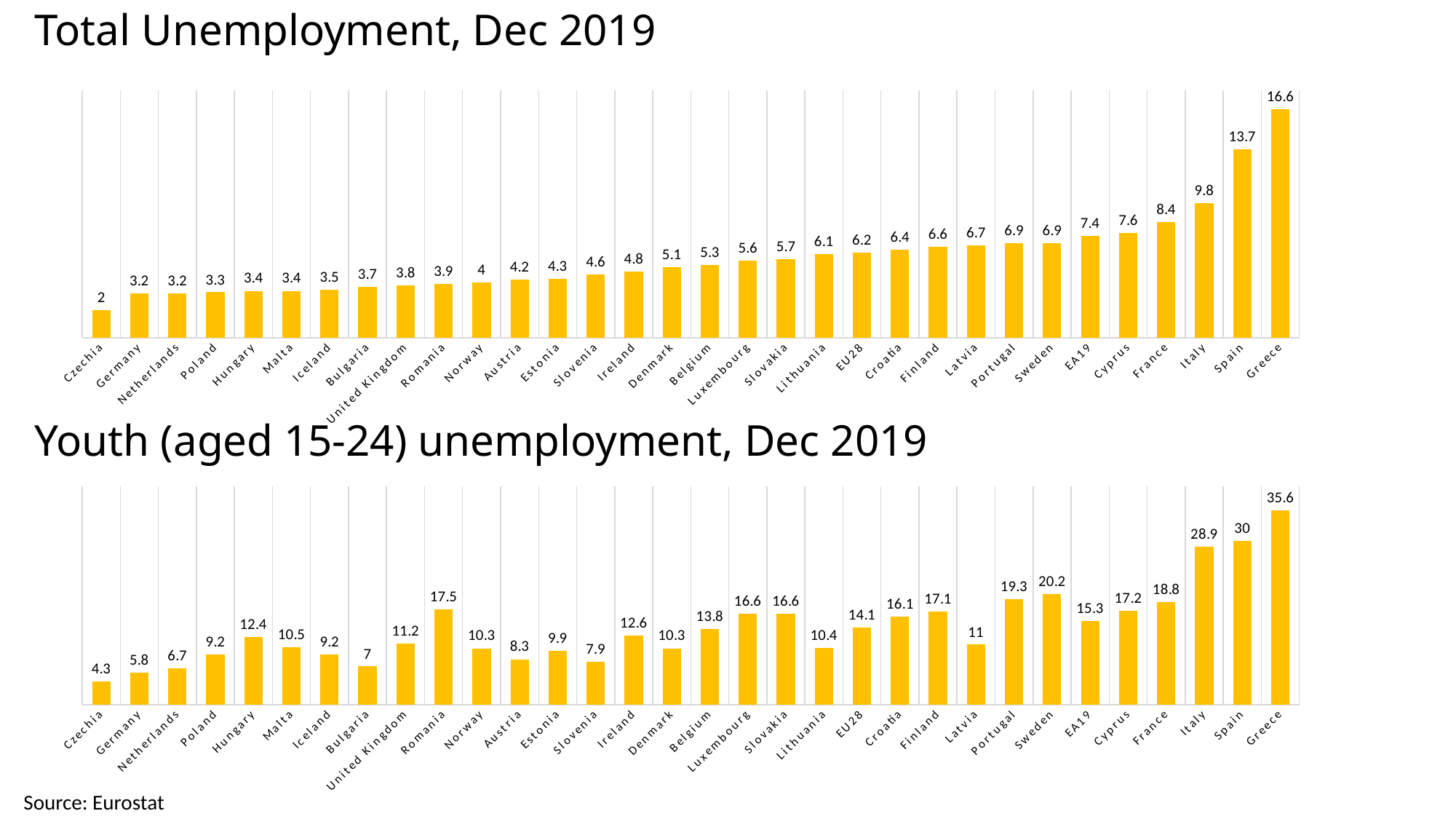
In the 'Youth (aged 15-24) unemployment, Dec 2019' chart, what is the value for Romania? 17.5 How many countries or regions are shown in the 'Total Unemployment, Dec 2019' chart? 32 In the 'Youth (aged 15-24) unemployment, Dec 2019' chart, which is larger, Sweden or Portugal? Sweden In the 'Total Unemployment, Dec 2019' chart, what is the value for EU28? 6.2 In the 'Total Unemployment, Dec 2019' chart, which country has the highest value? Greece What type of chart is the 'Youth (aged 15-24) unemployment, Dec 2019' chart? Bar chart In the 'Youth (aged 15-24) unemployment, Dec 2019' chart, which country has the highest value? Greece In the 'Total Unemployment, Dec 2019' chart, which country has the lowest value? Czechia In the 'Total Unemployment, Dec 2019' chart, what is the difference between Spain and Italy? 3.9 What source is cited at the bottom of the slide? Eurostat In the 'Total Unemployment, Dec 2019' chart, what is the value for Germany? 3.2 In the 'Youth (aged 15-24) unemployment, Dec 2019' chart, what is the difference between Greece and Spain? 5.6